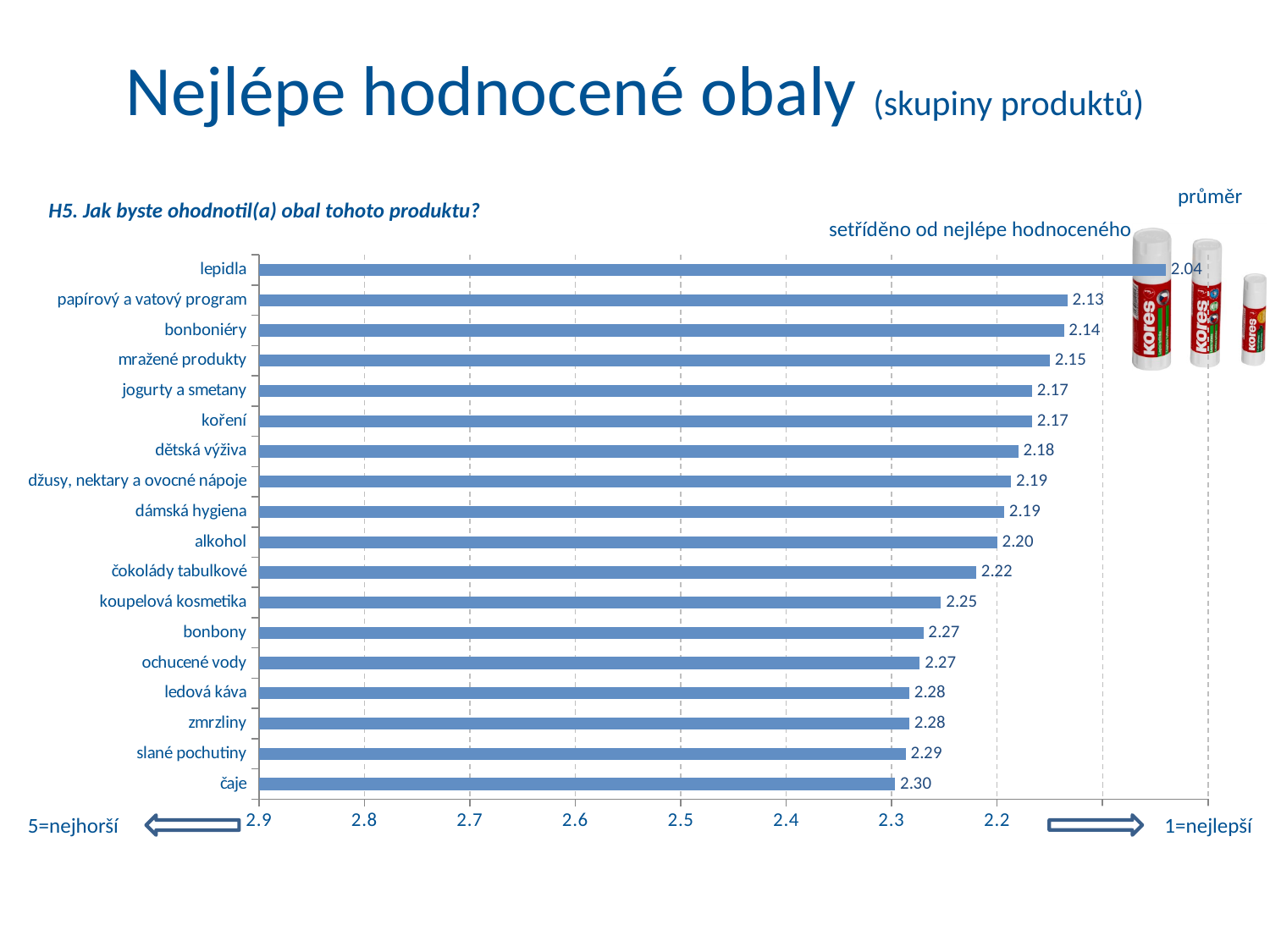
What type of chart is shown on the slide? bar chart Which has the larger value, zmrzliny or mražené produkty? zmrzliny What is the difference between the values for čaje and lepidla? 0.26 What is the value for čaje? 2.30 Which category has the highest numerical value? čaje What is the value for dětská výživa? 2.18 What is the value for koupelová kosmetika? 2.25 What is the value for lepidla? 2.04 How many product groups are shown in the chart? 18 What is the difference between the values for alkohol and bonboniéry? 0.06 What question is the chart based on, as stated above it? H5. Jak byste ohodnotil(a) obal tohoto produktu? Which category has the lowest numerical value? lepidla